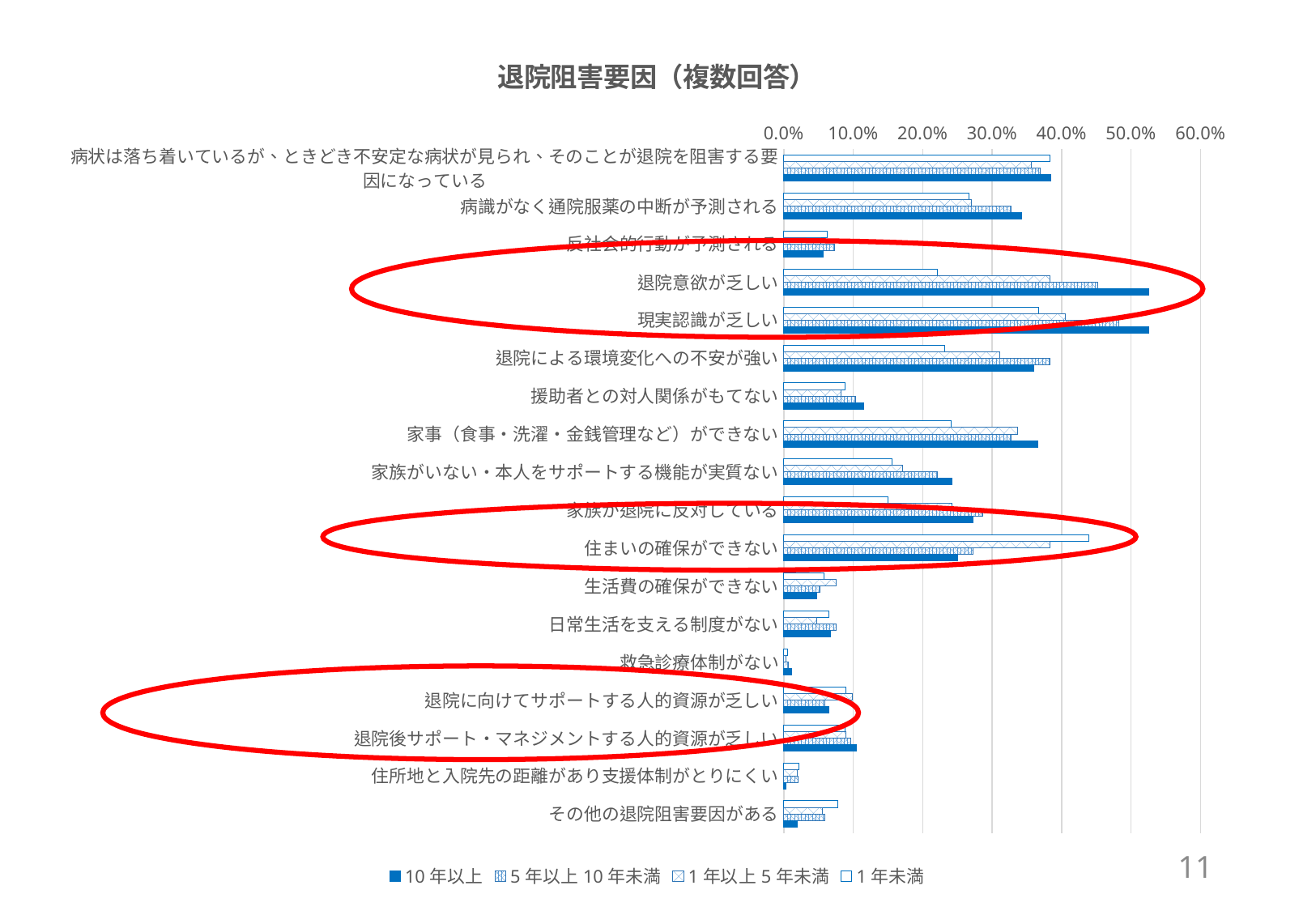
Which series is listed first in the legend? 10年以上 For 退院意欲が乏しい, which is larger: the value for 10年以上 or the value for 1年未満? 10年以上 Is the value of 10年以上 for 退院意欲が乏しい greater or less than 50.0%? greater What kind of chart is shown on the slide? bar chart Is the value of 1年未満 for 住まいの確保ができない greater or less than 40.0%? greater Is the value of 10年以上 for 病識がなく通院服薬の中断が予測される greater or less than 30.0%? greater How many series does the legend list? 4 For 住まいの確保ができない, which is larger: the value for 10年以上 or the value for 1年未満? 1年未満 How many categories are plotted on the chart? 18 Within the 1年未満 series, which category has the highest value? 住まいの確保ができない What is the title of the chart? 退院阻害要因（複数回答）